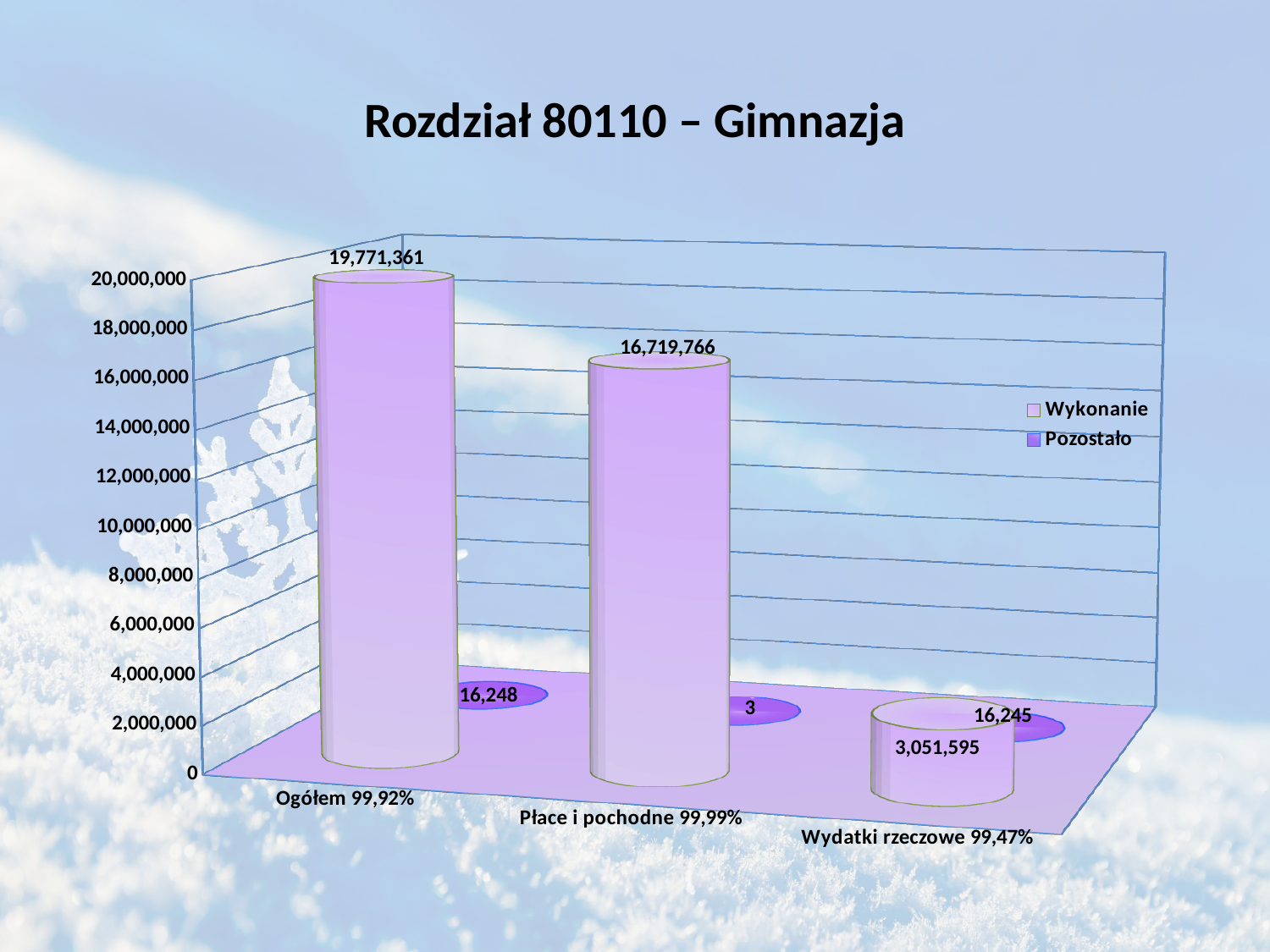
Which category has the lowest Pozostało value? Płace i pochodne 99,99% What is the Wykonanie value for Wydatki rzeczowe 99,47%? 3,051,595 What is the title of the chart? Rozdział 80110 – Gimnazja What is the Pozostało value for Ogółem 99,92%? 16,248 Which category has the highest Wykonanie value? Ogółem 99,92% What is the Wykonanie value for Płace i pochodne 99,99%? 16,719,766 What is the Pozostało value for Płace i pochodne 99,99%? 3 What is the difference between the Wykonanie values for Ogółem 99,92% and Płace i pochodne 99,99%? 3,051,595 What is the Pozostało value for Wydatki rzeczowe 99,47%? 16,245 How many categories are shown on the x axis? 3 How many series does the legend list? 2 What is the Wykonanie value for Ogółem 99,92%? 19,771,361